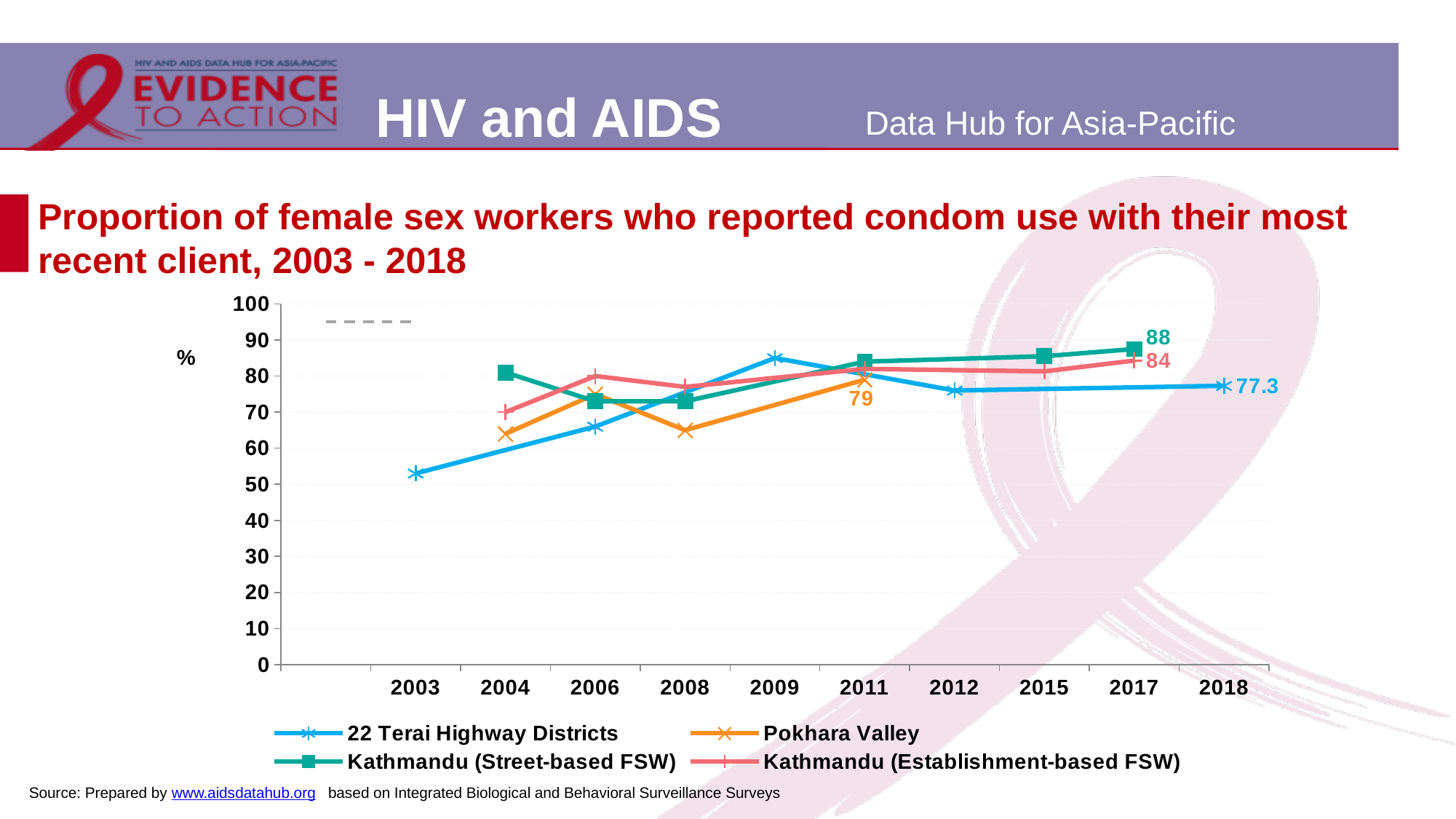
How many years are shown on the x axis? 10 How many series does the legend list? 4 Is the value for 22 Terai Highway Districts in 2003 greater or less than 60? less In 2017, which series has the larger value: Kathmandu (Street-based FSW) or Kathmandu (Establishment-based FSW)? Kathmandu (Street-based FSW) What kind of chart is shown on the slide? line chart What value is labelled for Pokhara Valley in 2011? 79 What value is labelled for Kathmandu (Establishment-based FSW) in 2017? 84 What value is labelled for Kathmandu (Street-based FSW) in 2017? 88 What value is labelled for 22 Terai Highway Districts in 2018? 77.3 Does the value for 22 Terai Highway Districts rise or fall from 2003 to 2009? rise Is the value for 22 Terai Highway Districts in 2009 greater or less than 80? greater What is the difference between the 2017 values for Kathmandu (Street-based FSW) and Kathmandu (Establishment-based FSW)? 4